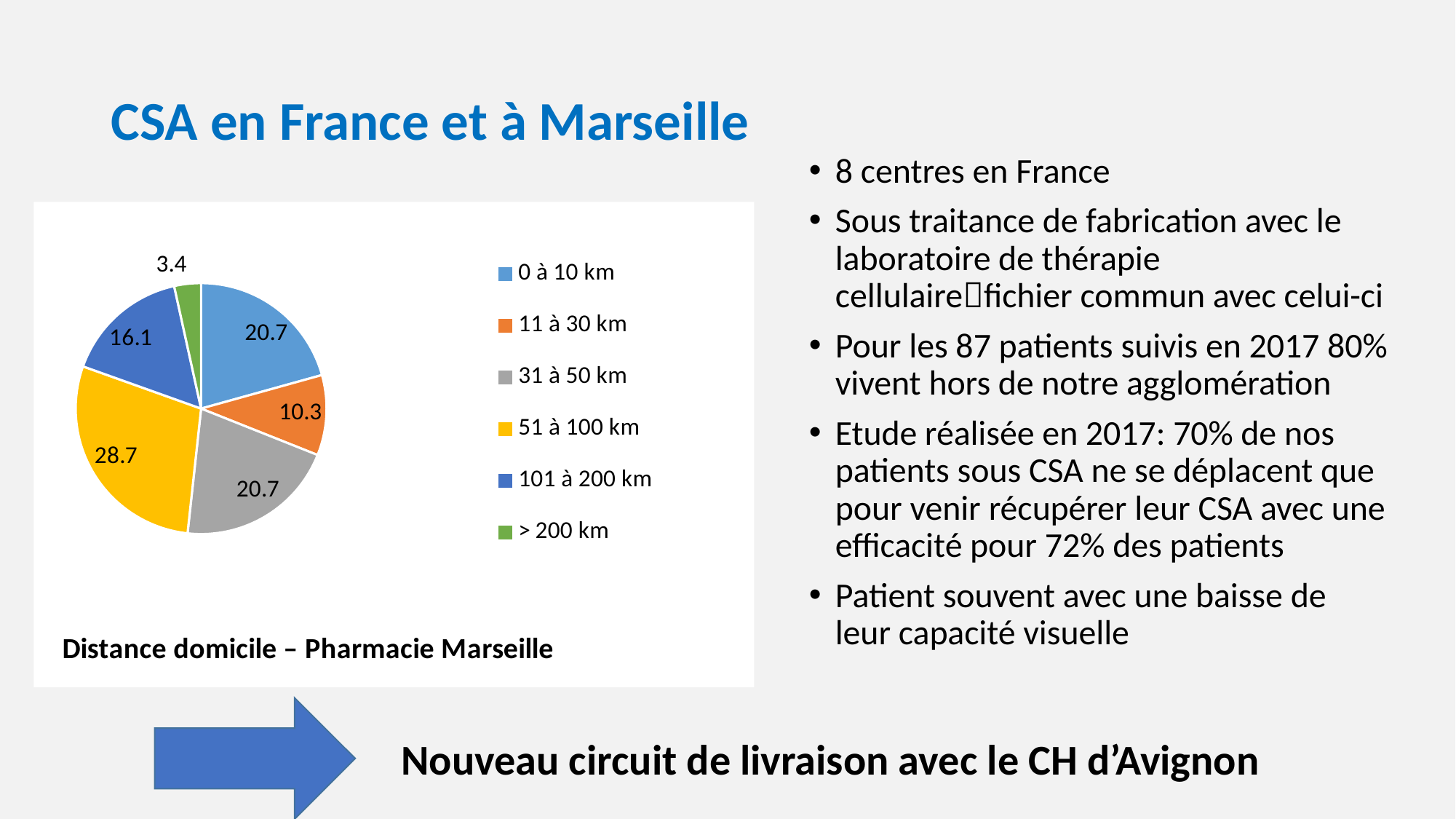
What is the difference between the values for 51 à 100 km and 101 à 200 km? 12.6 What kind of chart is shown on the slide? Pie chart Which distance category has the smallest slice in the pie chart? > 200 km What value is shown for the 11 à 30 km slice of the pie chart? 10.3 What value is shown for the 101 à 200 km slice of the pie chart? 16.1 What value is shown for the 51 à 100 km slice of the pie chart? 28.7 What is the difference between the values for 0 à 10 km and 11 à 30 km? 10.4 Which distance category has the largest slice in the pie chart? 51 à 100 km How many distance categories does the pie chart show? 6 Which is larger, the value for 101 à 200 km or the value for 11 à 30 km? 101 à 200 km What is the title shown below the pie chart? Distance domicile – Pharmacie Marseille What value is shown for the > 200 km slice of the pie chart? 3.4